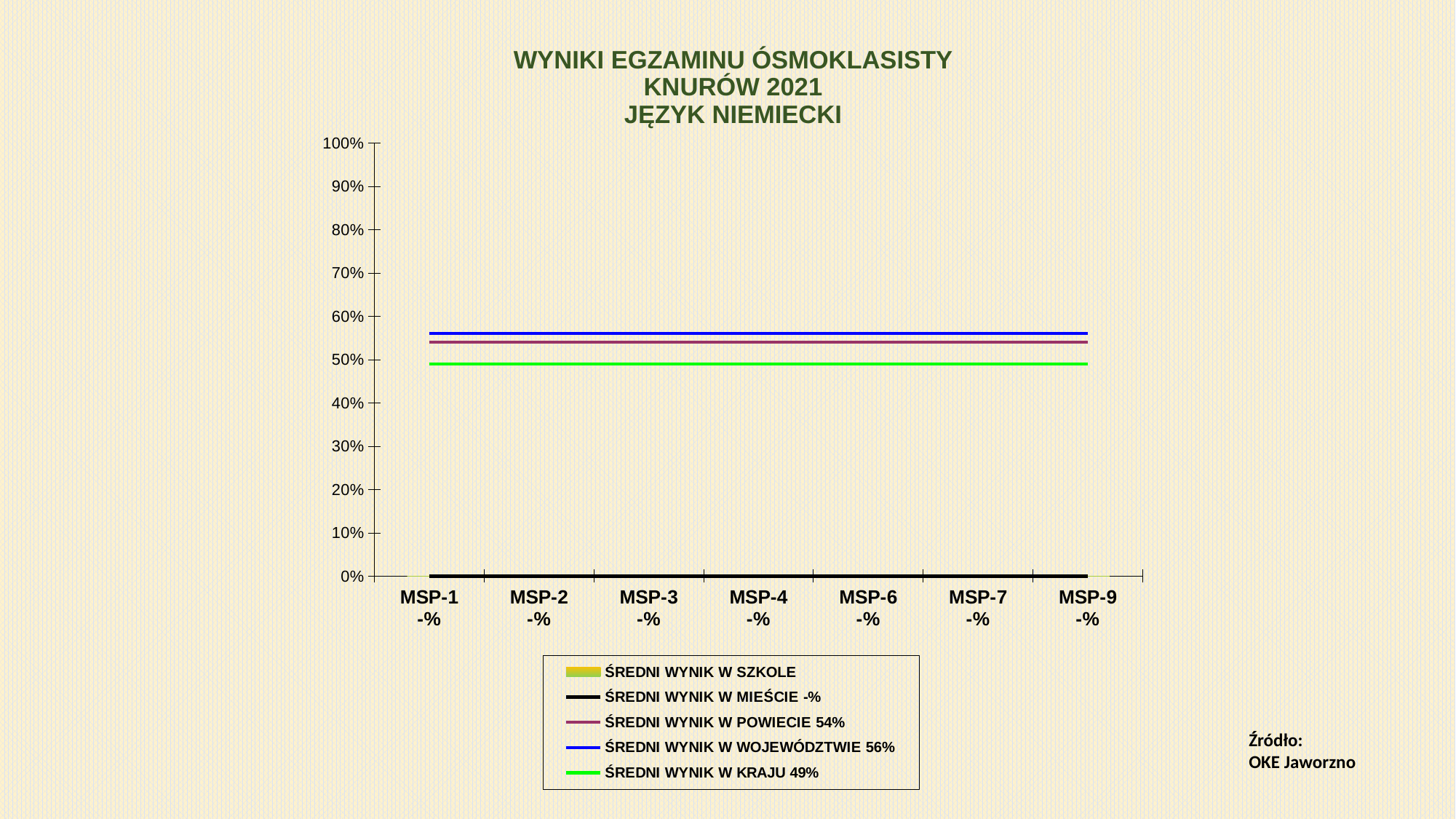
Do the reference lines rise, fall or stay flat across the x axis? stay flat What is the difference between the voivodeship average (56%) and the county average (54%)? 2 percentage points What is the average result in the voivodeship (ŚREDNI WYNIK W WOJEWÓDZTWIE) shown in the legend? 56% What subject is named in the chart title? JĘZYK NIEMIECKI Which is larger, the county average or the country average? the county average (54%) What is the average result in the county (ŚREDNI WYNIK W POWIECIE) shown in the legend? 54% Which of the reference lines (powiat, województwo, kraj) has the highest value? ŚREDNI WYNIK W WOJEWÓDZTWIE Is the value of the voivodeship average line greater or less than 50%? greater How many schools (MSP categories) are listed on the x axis? 7 What is the average result in the country (ŚREDNI WYNIK W KRAJU) shown in the legend? 49% How many series does the legend list? 5 Which of the reference lines (powiat, województwo, kraj) has the lowest value? ŚREDNI WYNIK W KRAJU